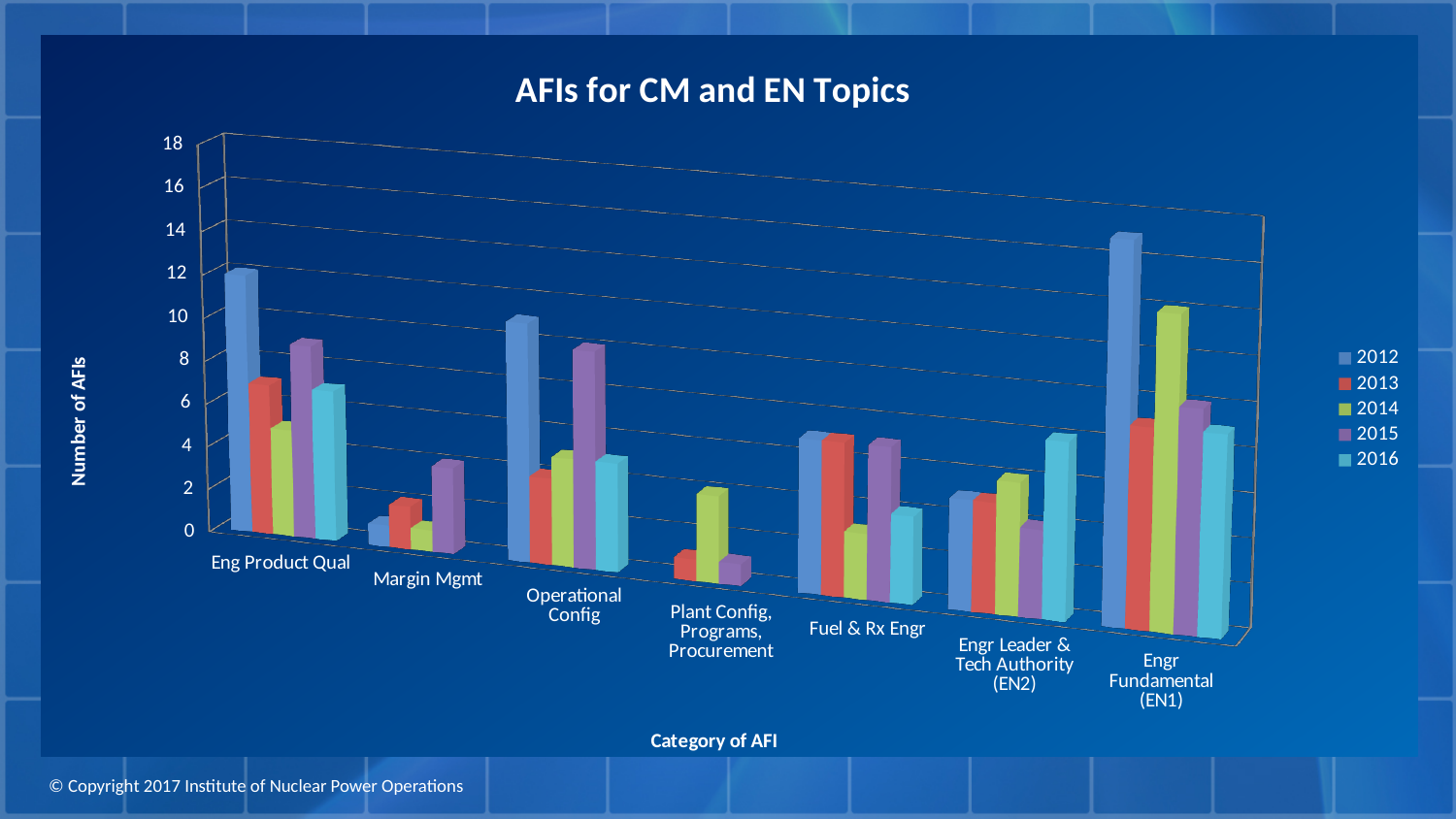
How many categories of AFI are shown on the x axis? 7 Is the 2013 value for Plant Config, Programs, Procurement greater or less than 4? less What type of chart is shown on the slide? Bar chart Is the 2012 value for Margin Mgmt greater or less than 4? less For Engr Fundamental (EN1), which is larger, the 2013 value or the 2014 value? 2014 What is the label of the vertical axis? Number of AFIs For Eng Product Qual, which is larger, the 2012 value or the 2013 value? 2012 Which category has the tallest 2014 bar? Engr Fundamental (EN1) Which category has the tallest 2012 bar? Engr Fundamental (EN1) What is the title of the chart? AFIs for CM and EN Topics How many series does the legend list? 5 Is the 2012 value for Engr Fundamental (EN1) greater or less than 10? greater